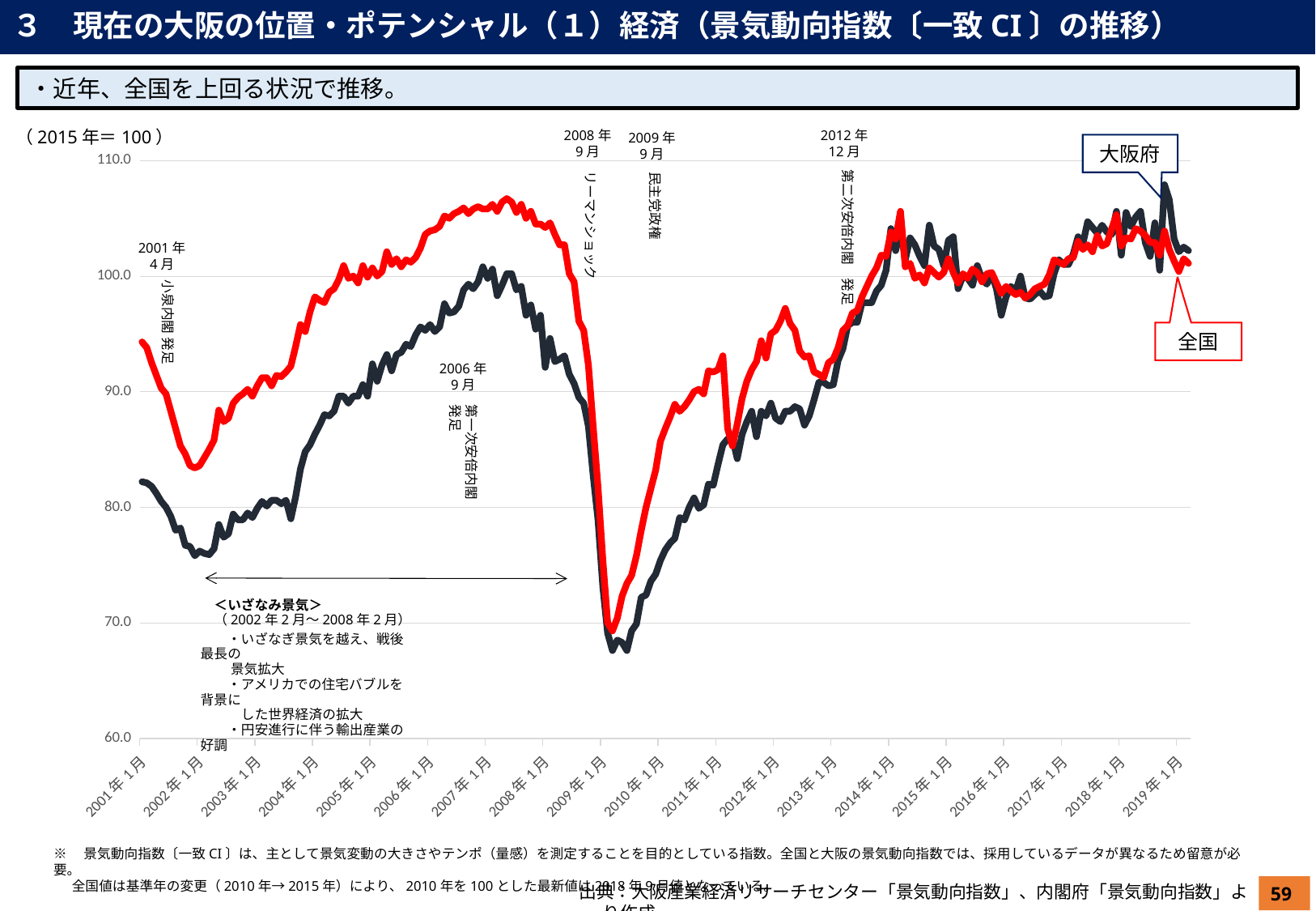
Which series is drawn in red? 全国 How many year labels are shown on the x axis? 19 At 2007年1月, which series has the higher value, 大阪府 or 全国? 全国 How many series does the chart show? 2 Do the values for 全国 rise or fall between 2008年9月 and early 2009? fall Is the value for 全国 at 2001年1月 greater or less than 90.0? greater At 2001年1月, which series has the higher value, 大阪府 or 全国? 全国 Is the value for 全国 at 2007年1月 greater or less than 100.0? greater Which series is drawn in dark navy? 大阪府 Is the value for 大阪府 at 2001年1月 greater or less than 80.0? greater What kind of chart is shown on the slide? line chart